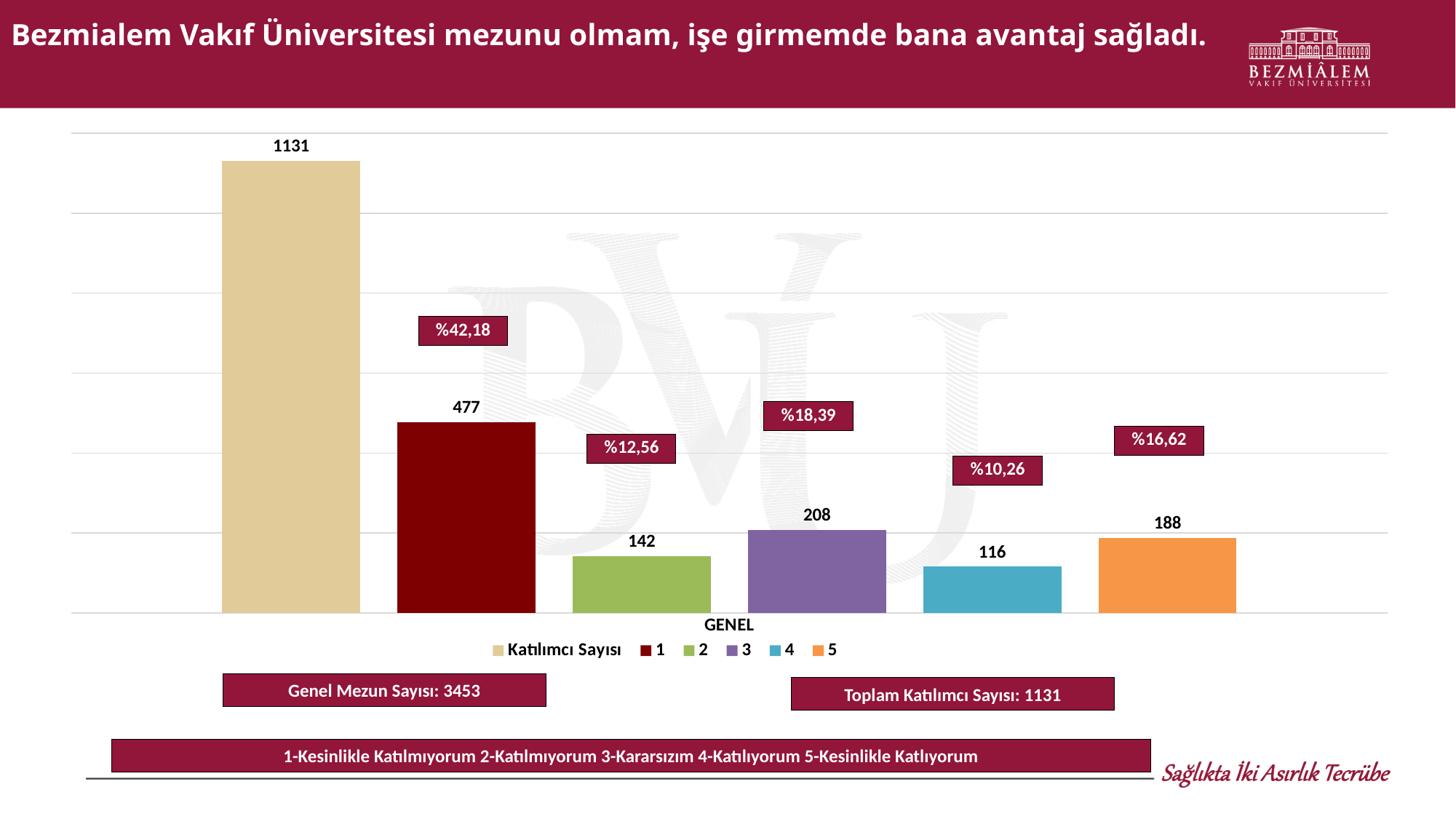
Among the response series 1 to 5, which has the highest value? 1 What is the category label shown on the x axis? GENEL What is the value of the bar for series '5'? 188 Which is larger, the value for series '2' or the value for series '5'? 5 How many series does the legend list? 6 What is the value of the bar for series '4'? 116 What is the value of the bar for series '1'? 477 What kind of chart is shown on the slide? Bar chart Among the response series 1 to 5, which has the lowest value? 4 What is the value of the 'Katılımcı Sayısı' bar? 1131 What percentage label is shown above the bar for series '3'? %18,39 What is the difference between the values for series '1' and series '3'? 269